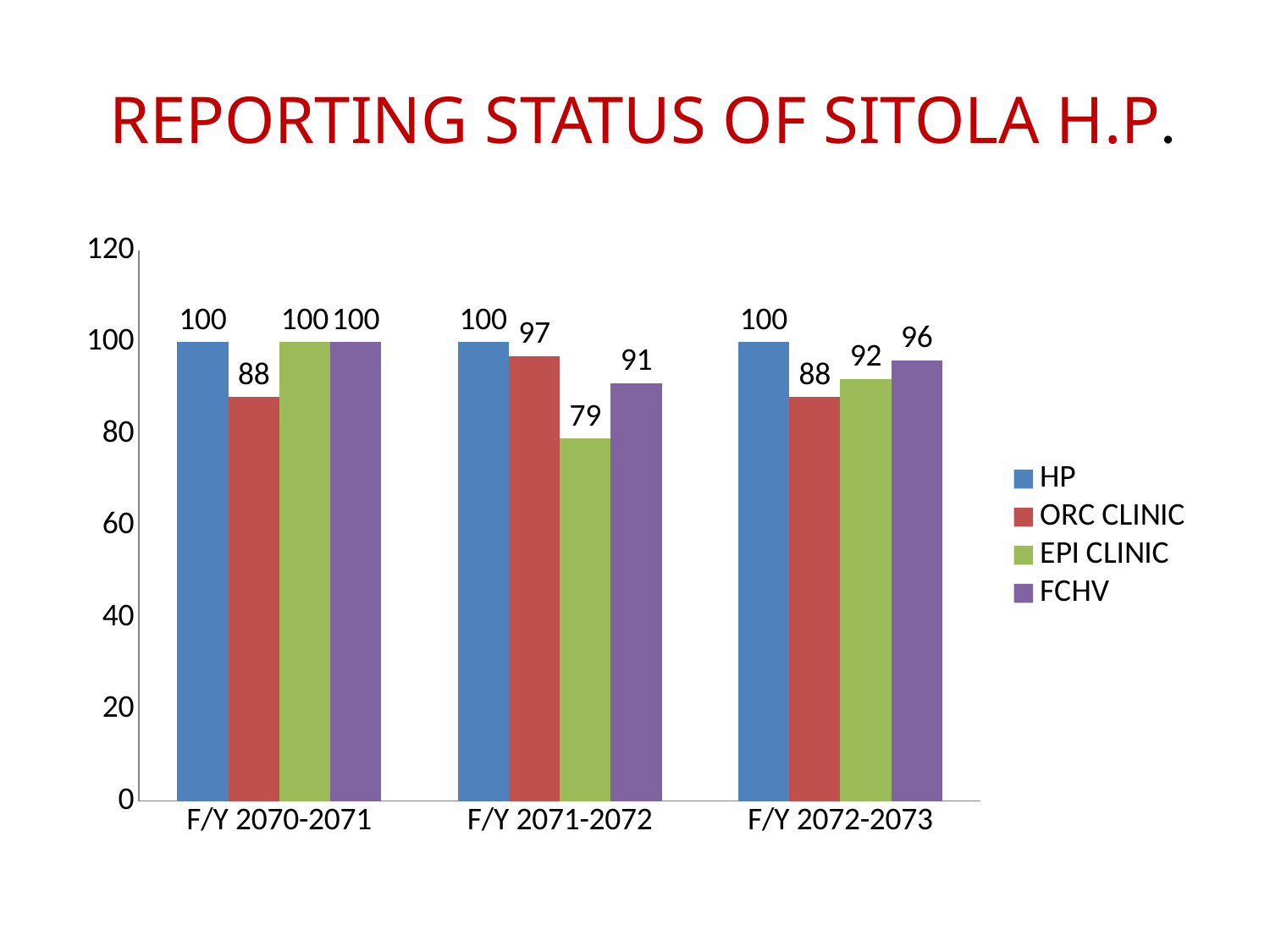
What is the value for ORC CLINIC in F/Y 2071-2072? 97 Does the EPI CLINIC value rise or fall from F/Y 2070-2071 to F/Y 2071-2072? Fall What kind of chart is shown on the slide? Bar chart What is the value for EPI CLINIC in F/Y 2071-2072? 79 Which series has the lowest value in F/Y 2072-2073? ORC CLINIC How many series does the legend list? 4 What is the difference between the HP value and the EPI CLINIC value in F/Y 2071-2072? 21 What is the value for FCHV in F/Y 2072-2073? 96 How many fiscal year categories are shown on the x axis? 3 Which is larger in F/Y 2072-2073: the EPI CLINIC value or the FCHV value? FCHV Which series has the lowest value in F/Y 2071-2072? EPI CLINIC What is the value for ORC CLINIC in F/Y 2070-2071? 88